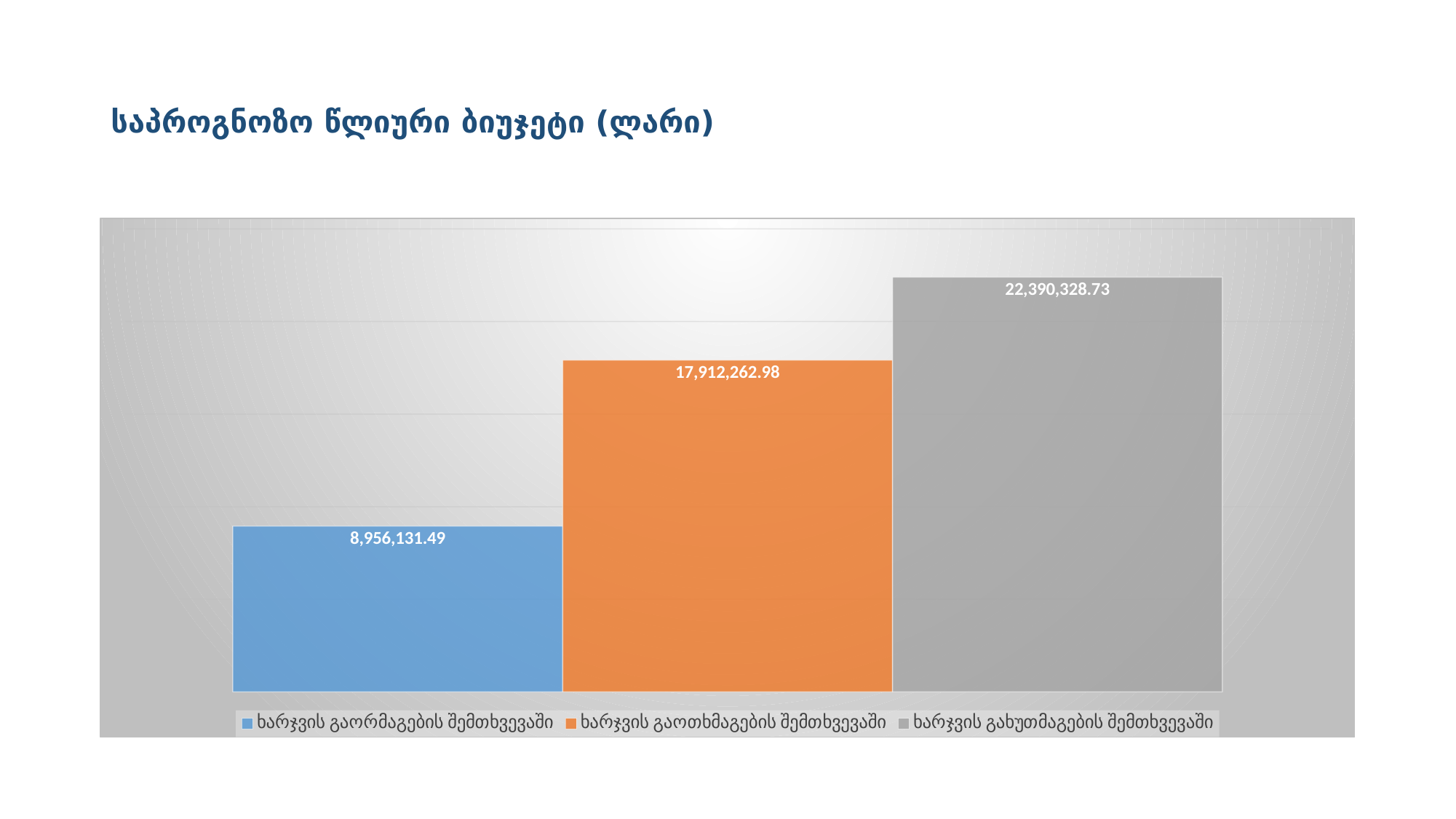
What is the value for ხარჯის გაოთხმაგების შემთხვევაში? 17,912,262.98 How many series does the legend list? 3 Which series has the highest value? ხარჯვის გახუთმაგების შემთხვევაში What is the difference between the values for ხარჯის გახუთმაგების შემთხვევაში and ხარჯის გაოთხმაგების შემთხვევაში? 4,478,065.75 What is the value for ხარჯის გახუთმაგების შემთხვევაში? 22,390,328.73 What is the title of the slide? საპროგნოზო წლიური ბიუჯეტი (ლარი) Which is larger: the value for ხარჯის გაოთხმაგების შემთხვევაში or the value for ხარჯის გახუთმაგების შემთხვევაში? ხარჯვის გახუთმაგების შემთხვევაში Which series has the lowest value? ხარჯვის გაორმაგების შემთხვევაში What is the difference between the values for ხარჯის გაოთხმაგების შემთხვევაში and ხარჯის გაორმაგების შემთხვევაში? 8,956,131.49 What kind of chart is shown on the slide? Bar chart Do the bar values rise or fall from left to right? Rise What is the value for ხარჯის გაორმაგების შემთხვევაში? 8,956,131.49